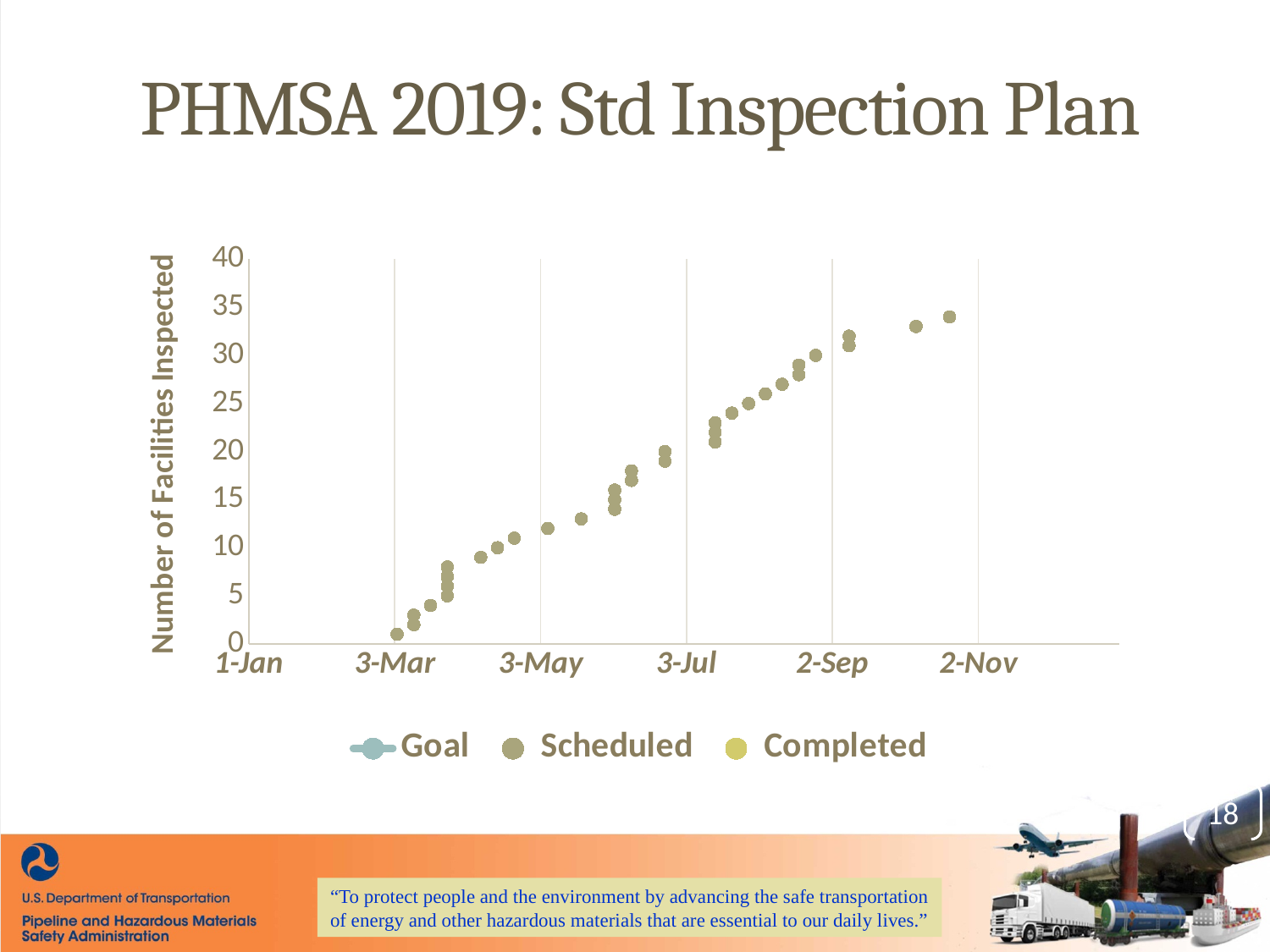
Is the value of the point plotted at about 3-May greater or less than 10? greater How many date labels are shown along the horizontal axis? 6 Which date label appears first on the horizontal axis? 1-Jan What are the three series named in the legend? Goal, Scheduled, Completed What is the label of the vertical axis? Number of Facilities Inspected Do the plotted points rise or fall as the dates move from 3-Mar toward 2-Nov? rise How many series does the chart's legend list? 3 What kind of chart is shown on the slide? scatter chart What is the highest value shown on the vertical axis? 40 Is the value of the first plotted point, near 3-Mar, greater or less than 5? less Is the value of the last plotted point, near 2-Nov, greater or less than 30? greater What is the title of the chart on the slide? PHMSA 2019: Std Inspection Plan